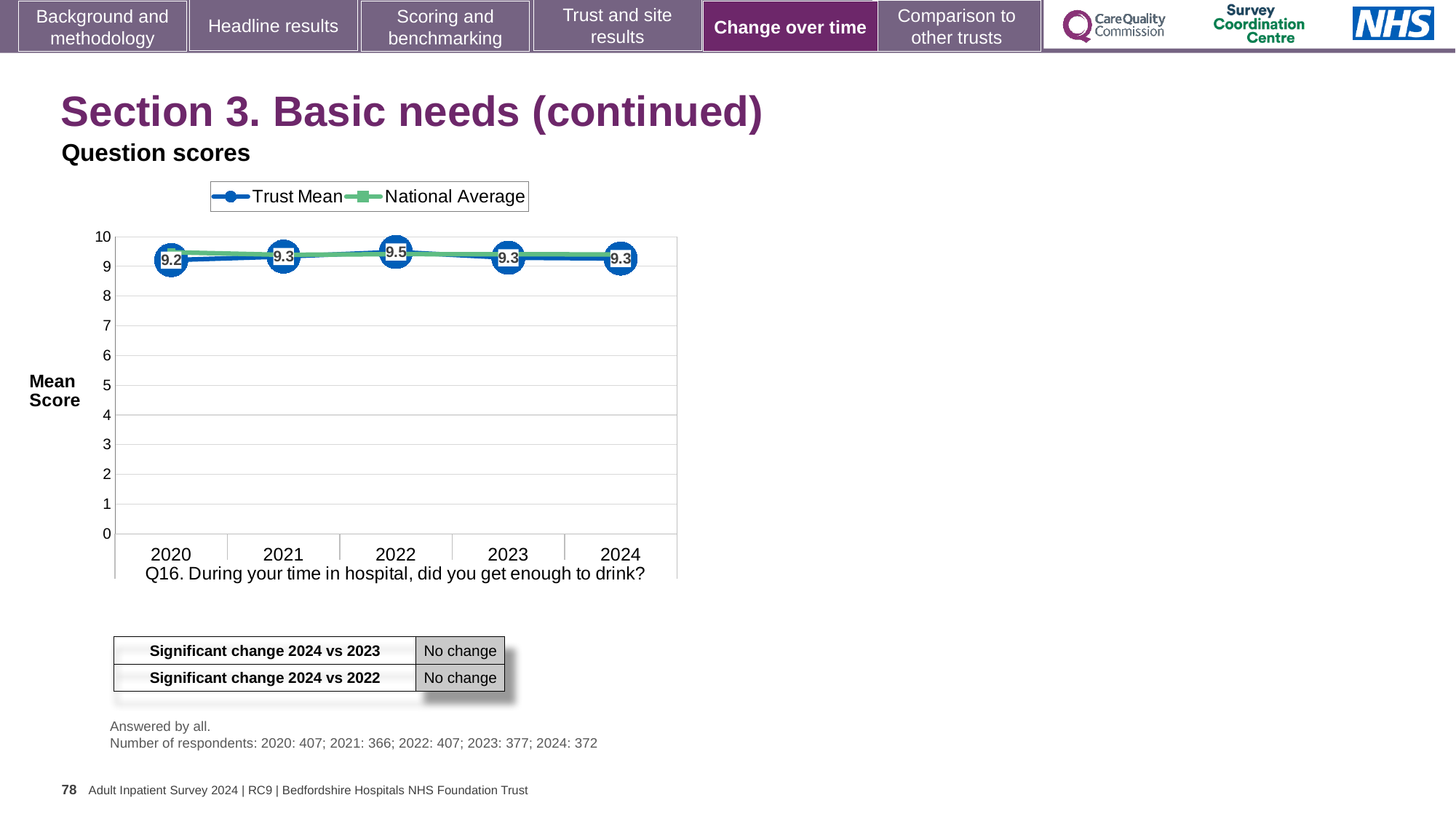
What kind of chart is shown on the slide? Line chart Which year has the larger Trust Mean score, 2022 or 2020? 2022 In which year is the Trust Mean score lowest? 2020 How many series does the legend list? 2 What is the label on the y axis of the chart? Mean Score What is the difference between the Trust Mean scores for 2022 and 2020? 0.3 What is the Trust Mean score for 2022? 9.5 What is the Trust Mean score for 2020? 9.2 What is the Trust Mean score for 2024? 9.3 How many years are plotted on the x axis? 5 Is the Trust Mean score for 2023 greater or less than 5? greater In which year is the Trust Mean score highest? 2022